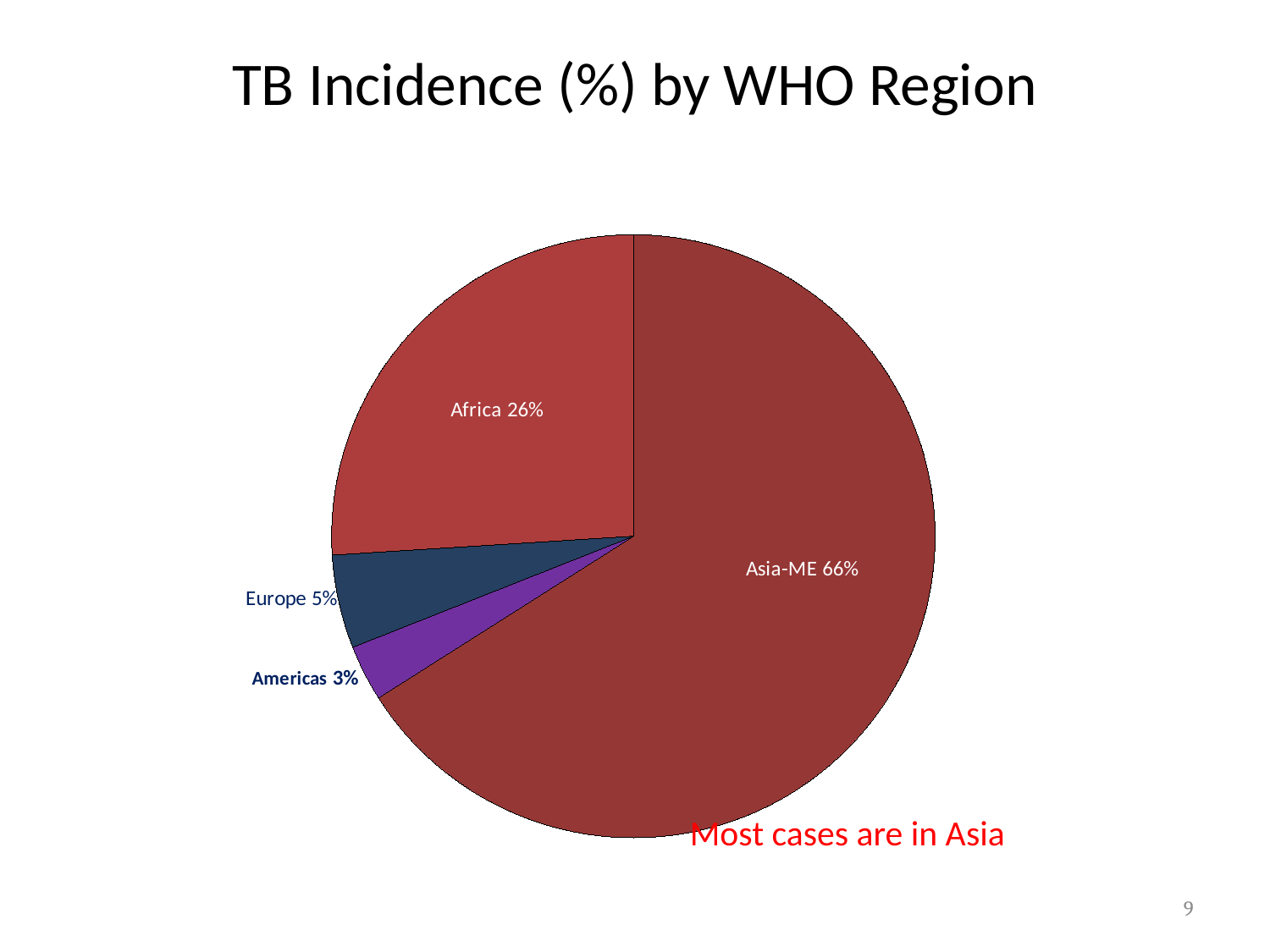
What is the combined share of Europe and the Americas? 8% What percentage of TB incidence is attributed to Europe? 5% Which region has the largest share of TB incidence? Asia-ME What is the title of the chart? TB Incidence (%) by WHO Region What is the difference in percentage points between Asia-ME and Africa? 40 What percentage of TB incidence is attributed to the Americas? 3% What percentage of TB incidence is attributed to Africa? 26% How many regions are shown in the pie chart? 4 Which region has the smallest share of TB incidence? Americas What kind of chart is shown on the slide? pie chart What percentage of TB incidence is attributed to Asia-ME? 66% Which has a larger share, Europe or the Americas? Europe